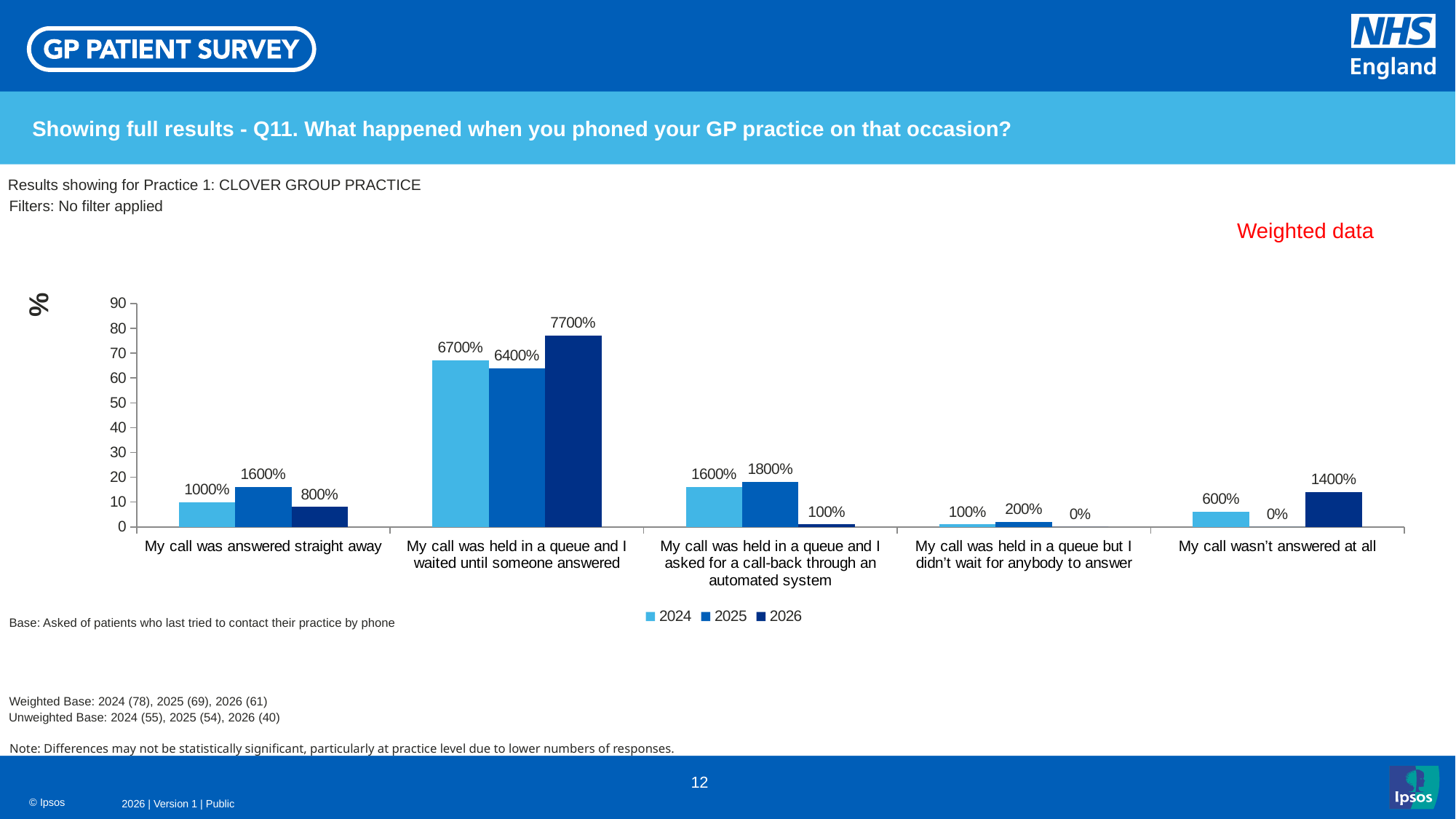
What kind of chart is shown on the slide? Bar chart How many categories are shown on the x axis? 5 For "My call was answered straight away", which year has the larger value, 2025 or 2026? 2025 What is the 2026 value for "My call was held in a queue and I waited until someone answered"? 7700% Which years are listed in the chart legend? 2024, 2025, 2026 Which category has the lowest 2024 value? My call was held in a queue but I didn't wait for anybody to answer How many series does the legend list? 3 What is the 2026 value for "My call wasn't answered at all"? 1400% Which category has the highest 2025 value? My call was held in a queue and I waited until someone answered What is the 2025 value for "My call was held in a queue and I asked for a call-back through an automated system"? 1800% What is the 2024 value for "My call was answered straight away"? 1000% What is the difference between the 2026 and 2024 values for "My call was held in a queue and I waited until someone answered"? 1000%